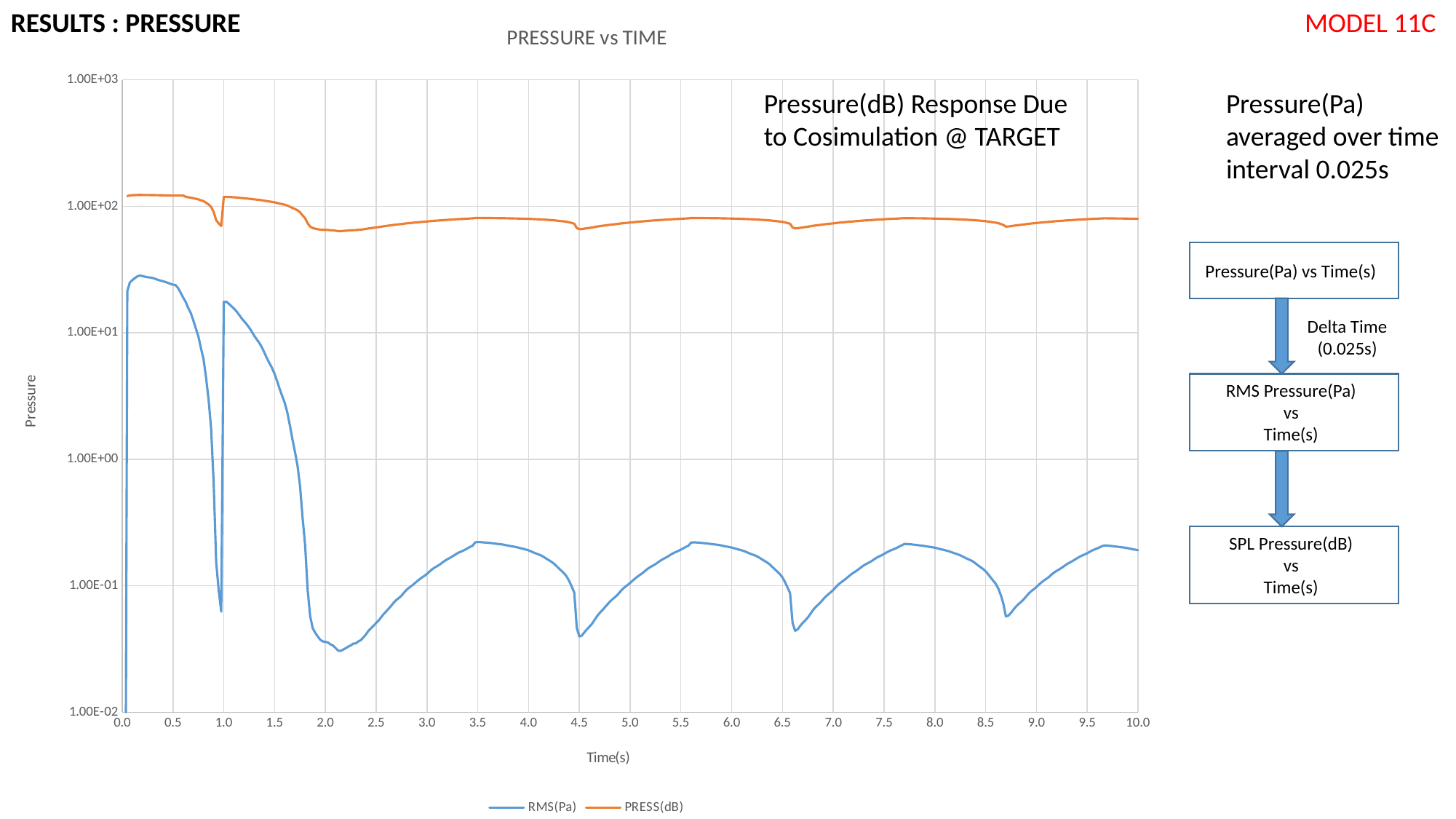
At time 5.0 s, which series has the higher value, RMS(Pa) or PRESS(dB)? PRESS(dB) What is the title of the chart? PRESSURE vs TIME Does the PRESS(dB) series rise or fall between time 1.5 s and 2.0 s? fall Is the value of RMS(Pa) at time 0.5 s greater or less than 1.00E+01? greater How many series does the legend list? 2 Is the value of PRESS(dB) at time 5.0 s greater or less than 1.00E+01? greater Does the RMS(Pa) series rise or fall between time 2.5 s and 3.5 s? rise Is the value of PRESS(dB) at time 5.0 s greater or less than 1.00E+02? less What kind of chart is shown on the slide? line chart What are the two series named in the legend? RMS(Pa) and PRESS(dB)